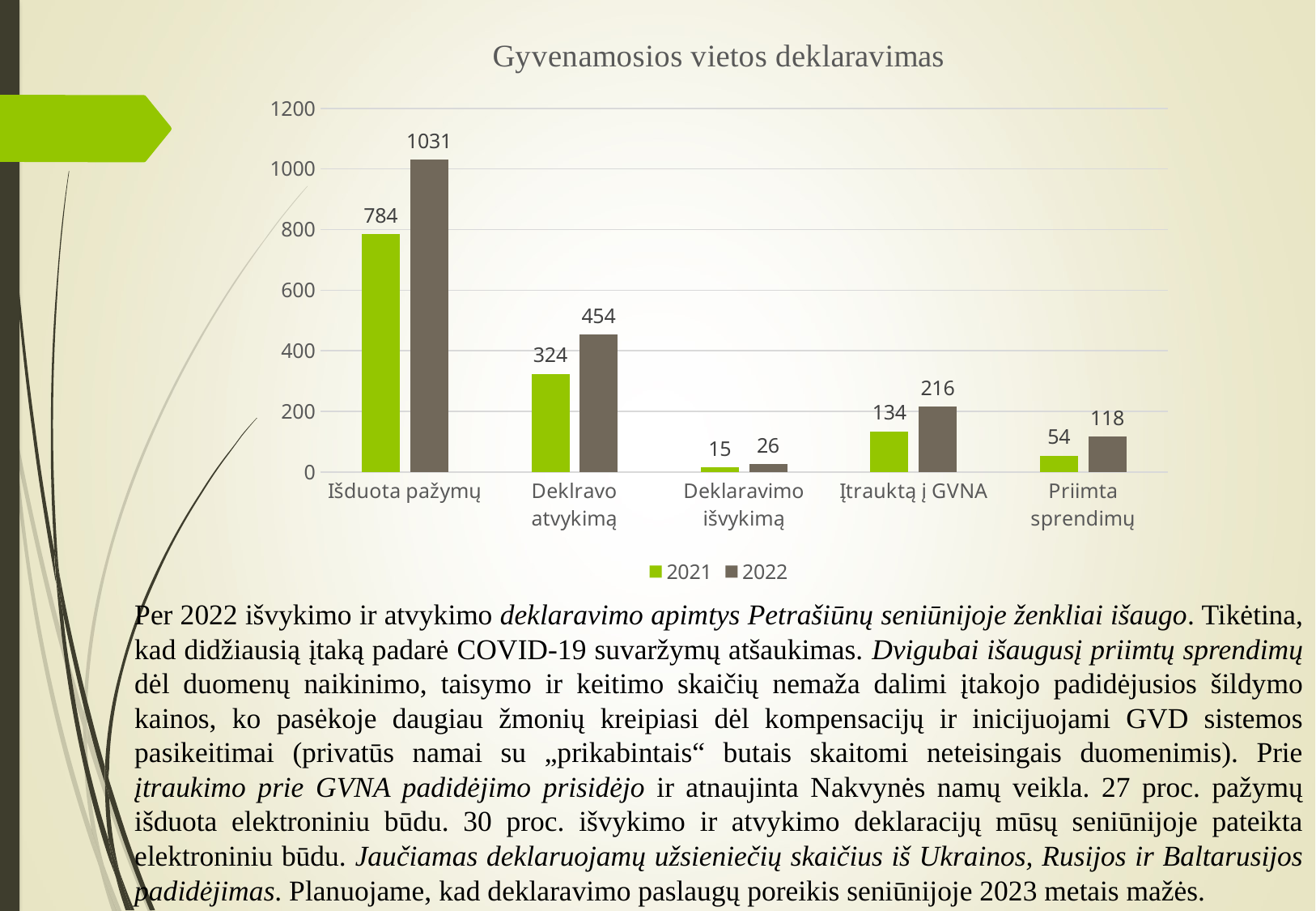
Which is larger for Deklaravimo išvykimą: the 2021 value or the 2022 value? 2022 Which category has the lowest 2022 value? Deklaravimo išvykimą What is the 2021 value for Deklravo atvykimą? 324 What kind of chart is shown on the slide? Bar chart What is the 2022 value for Priimta sprendimų? 118 What is the difference between the 2022 and 2021 values for Įtrauktą į GVNA? 82 What is the difference between the 2022 and 2021 values for Išduota pažymų? 247 How many categories are shown on the x axis? 5 How many series does the legend list? 2 Which category has the highest 2021 value? Išduota pažymų What is the title of the chart? Gyvenamosios vietos deklaravimas What is the 2022 value for Išduota pažymų? 1031